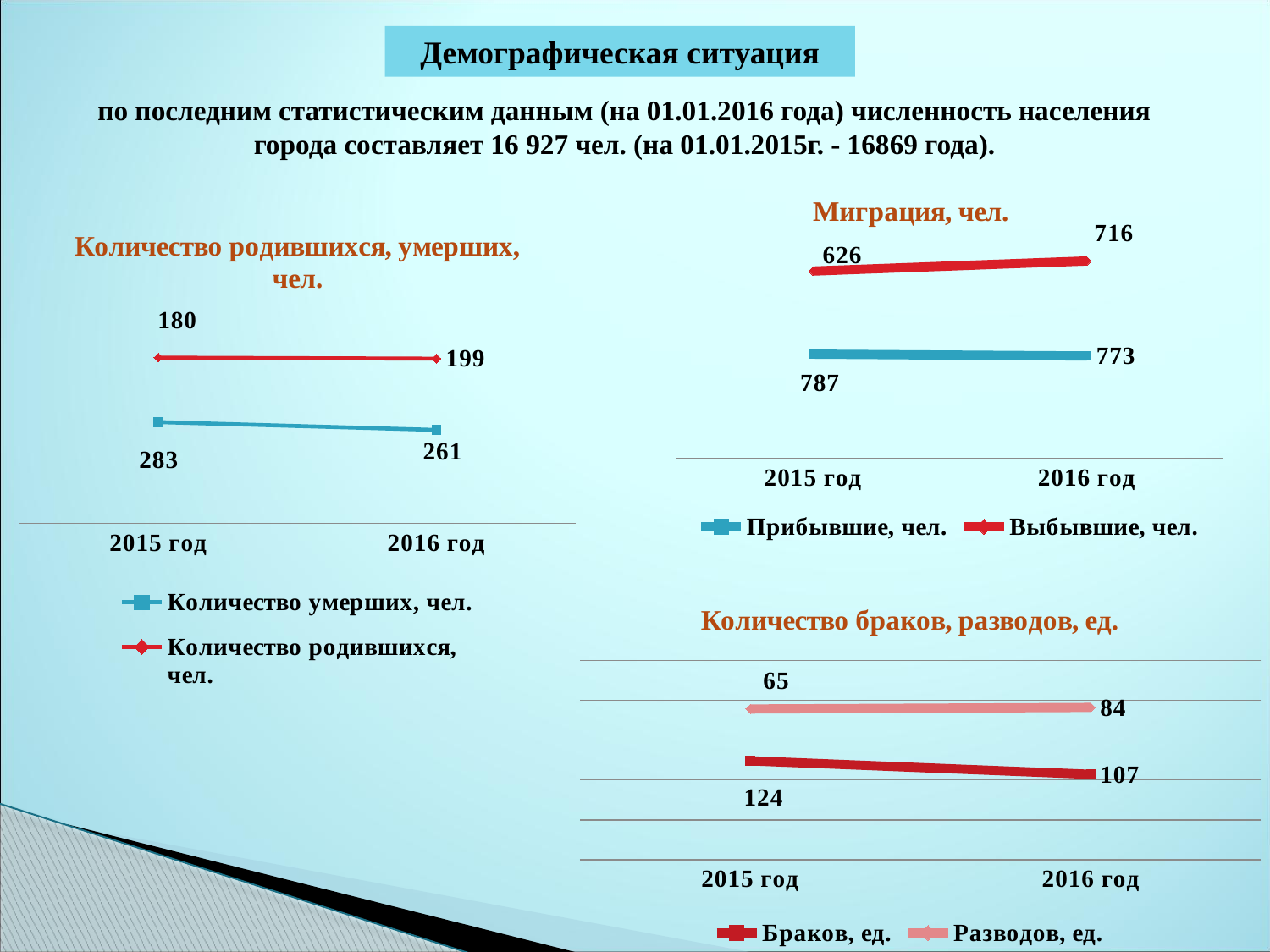
In the chart 'Количество родившихся, умерших, чел.', what is the value for Количество родившихся in 2016 год? 199 In the chart 'Миграция, чел.', what is the value for Прибывшие in 2015 год? 787 How many series does the legend of the chart 'Миграция, чел.' list? 2 In the chart 'Количество браков, разводов, ед.', what is the value for Браков in 2015 год? 124 In the chart 'Количество родившихся, умерших, чел.', does the Количество умерших series rise or fall from 2015 год to 2016 год? fall In the chart 'Количество родившихся, умерших, чел.', what is the difference between Количество умерших and Количество родившихся in 2016 год? 62 In the chart 'Миграция, чел.', which is larger in 2015 год: Прибывшие or Выбывшие? Прибывшие In the chart 'Миграция, чел.', what is the value for Выбывшие in 2016 год? 716 In the chart 'Количество родившихся, умерших, чел.', what is the value for Количество умерших in 2015 год? 283 In the chart 'Количество браков, разводов, ед.', does the Разводов series rise or fall from 2015 год to 2016 год? rise In the chart 'Количество браков, разводов, ед.', what is the value for Разводов in 2016 год? 84 In the chart 'Миграция, чел.', by how much did Выбывшие increase from 2015 год to 2016 год? 90